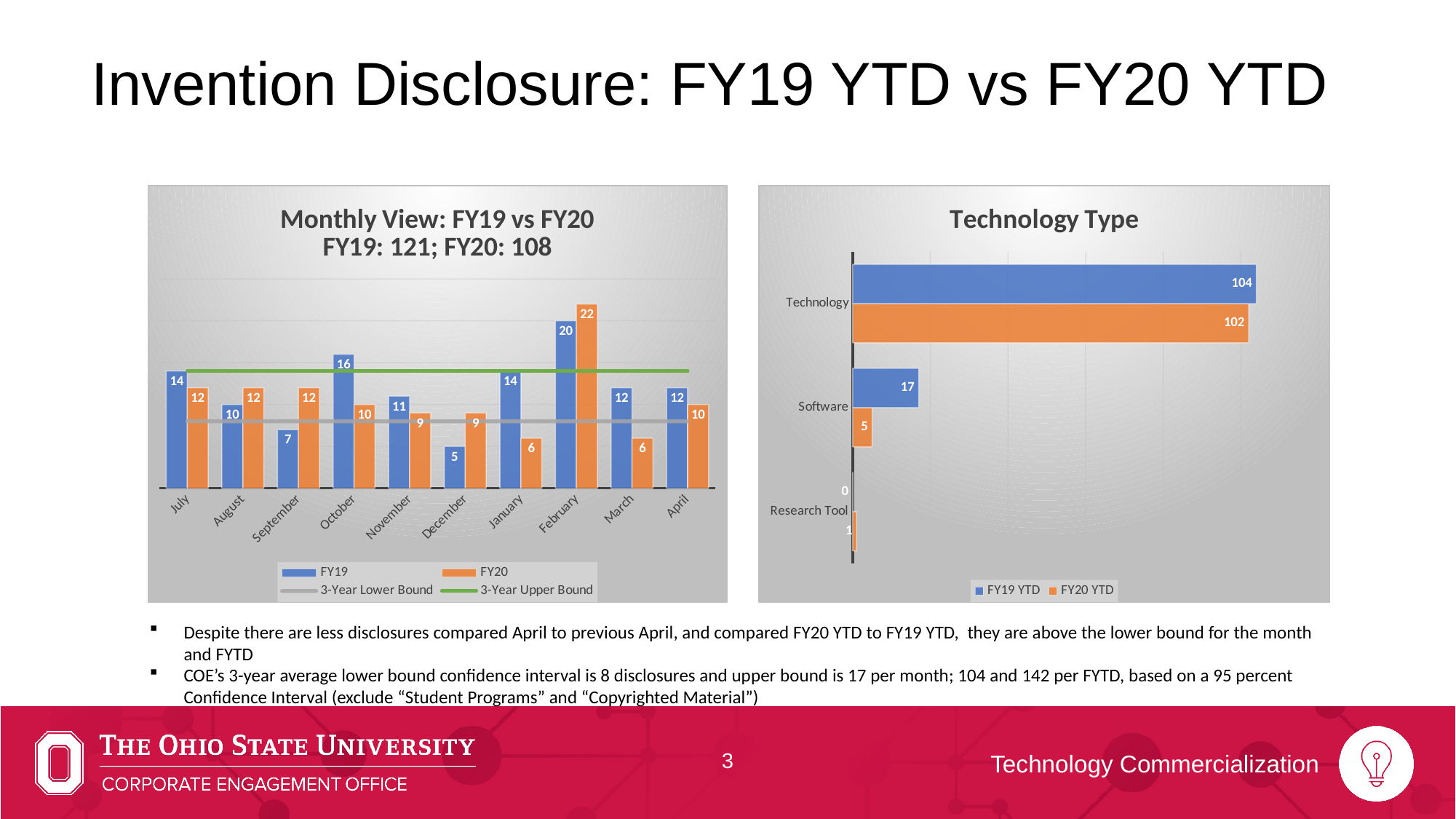
In the Monthly View chart, how many months are shown on the x axis? 10 In the Monthly View chart, how many entries does the legend list? 4 What kind of chart is the Technology Type chart? Bar chart In the Technology Type chart, which category has the lowest FY19 YTD value? Research Tool In the Monthly View chart, what is the FY20 value for December? 9 In the Monthly View chart, what is the FY19 value for February? 20 In the Monthly View chart, which is larger for April: FY19 or FY20? FY19 In the Technology Type chart, what is the difference between FY19 YTD and FY20 YTD for Technology? 2 In the Monthly View chart, what is the difference between the FY19 and FY20 values for October? 6 In the Monthly View chart, which month has the highest FY20 value? February In the Monthly View chart, which month has the lowest FY19 value? December In the Technology Type chart, what is the FY20 YTD value for Software? 5